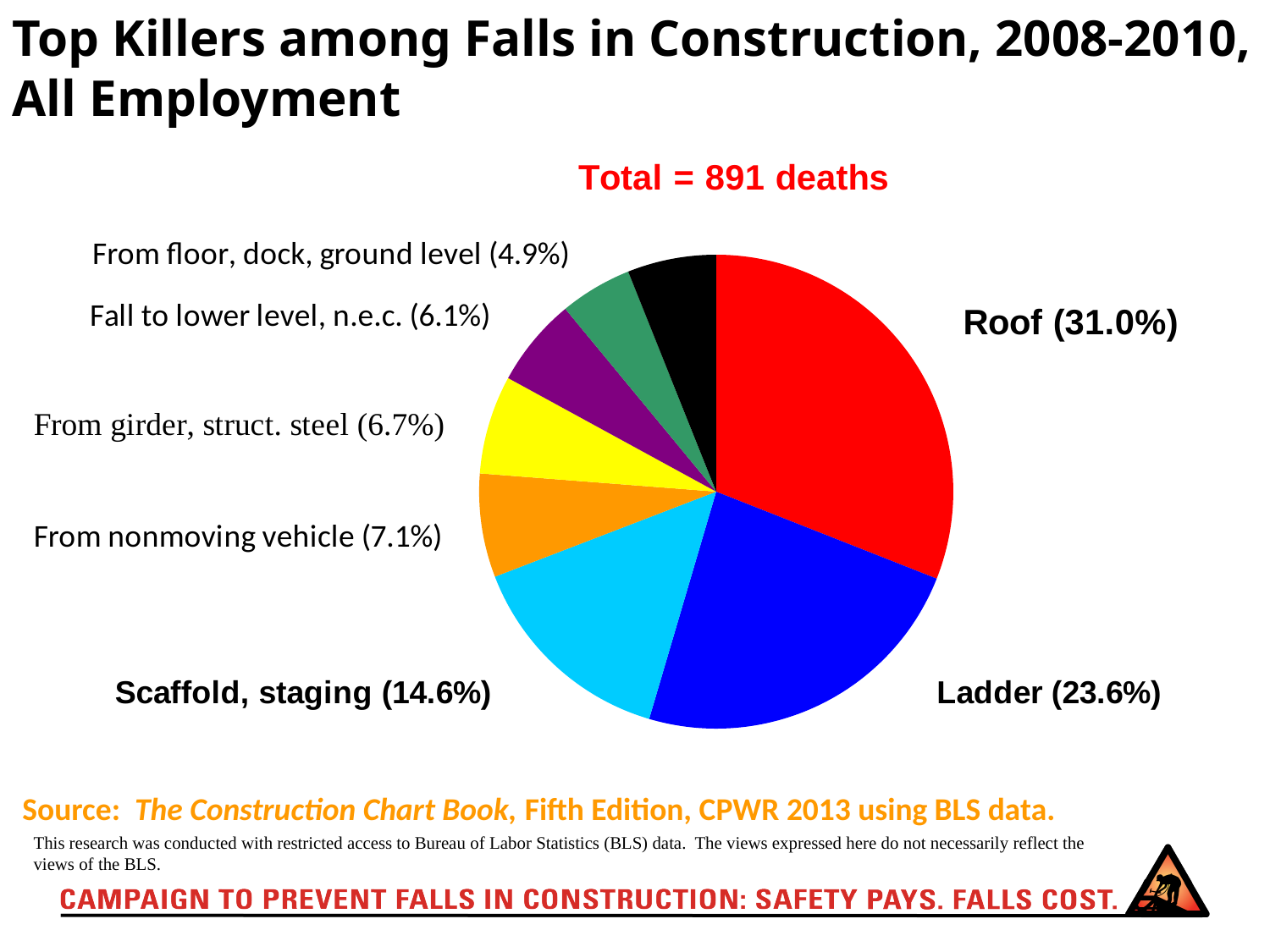
Which category accounts for the largest share of fall deaths? Roof What is the difference in percentage points between the Roof and Ladder shares? 7.4 What share of fall deaths is attributed to falls from floor, dock, ground level? 4.9% How many categories are shown in the pie chart? 8 What total number of deaths does the chart represent? 891 deaths Which category accounts for the smallest share of fall deaths? From floor, dock, ground level What kind of chart is shown on the slide? Pie chart What share of fall deaths is attributed to Scaffold, staging? 14.6% What share of fall deaths is attributed to falls from nonmoving vehicle? 7.1% Which has a larger share, falls from girder, struct. steel or falls to lower level, n.e.c.? From girder, struct. steel What share of fall deaths is attributed to Ladder? 23.6% What share of fall deaths is attributed to Roof? 31.0%